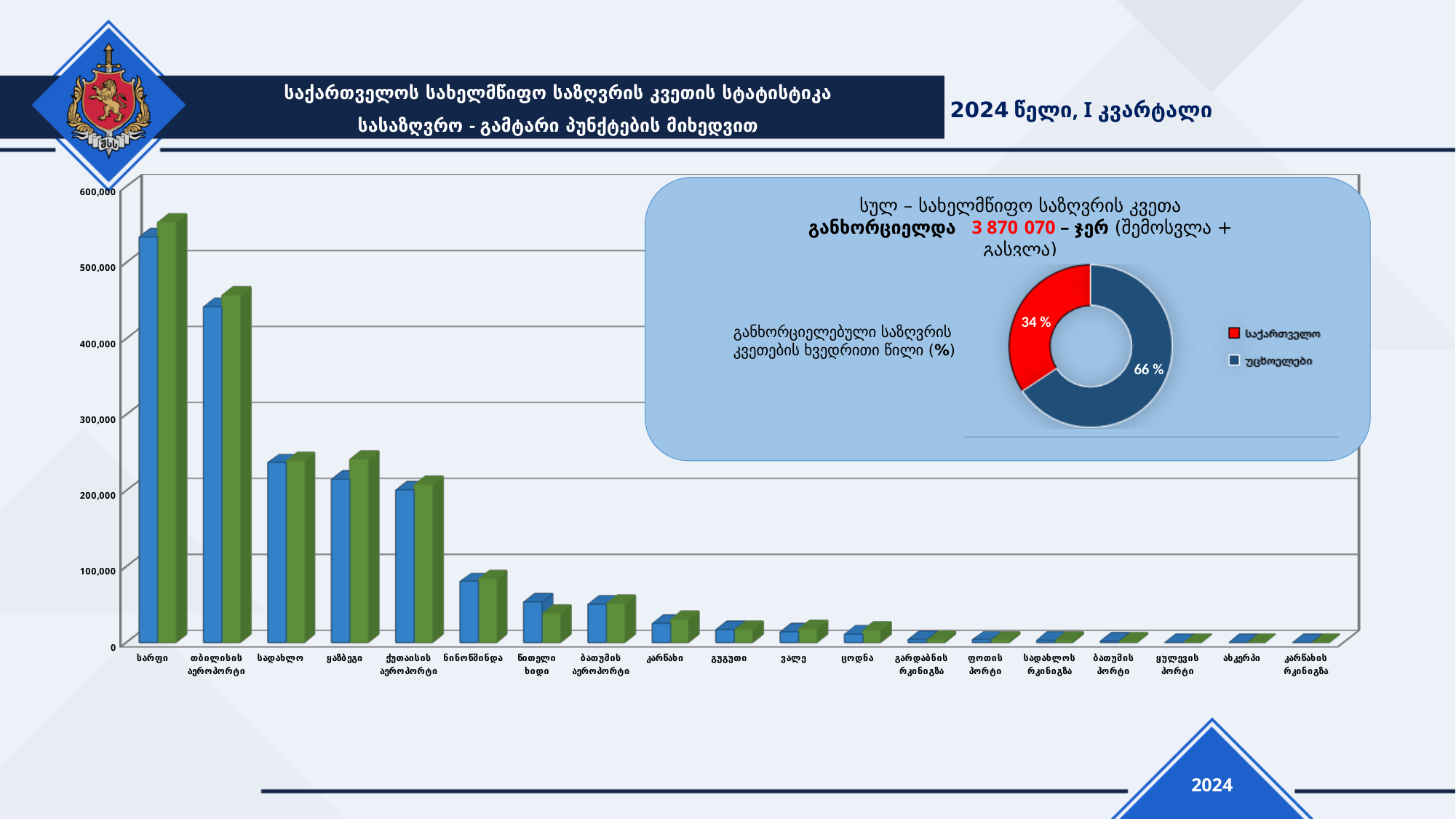
In the bar chart on the left, how many categories are shown on the x axis? 19 In the bar chart on the left, is the green bar for ნინოწმინდა greater or less than 100,000? less In the bar chart on the left, which is larger: the blue bar for ყაზბეგი or the blue bar for ნინოწმინდა? ყაზბეგი What kind of chart is the large chart on the left of the slide? bar chart In the bar chart on the left, is the blue bar for სადახლო greater or less than 200,000? greater In the bar chart on the left, do the values generally rise or fall from left to right along the x axis? fall In the bar chart on the left, which category has the highest values? სარფი In the donut chart on the right, what share is shown for უცხოელები? 66 % In the bar chart on the left, is the blue bar for სარფი greater or less than 500,000? greater In the donut chart on the right, what share is shown for საქართველო? 34 % In the donut chart on the right, how many entries does the legend list? 2